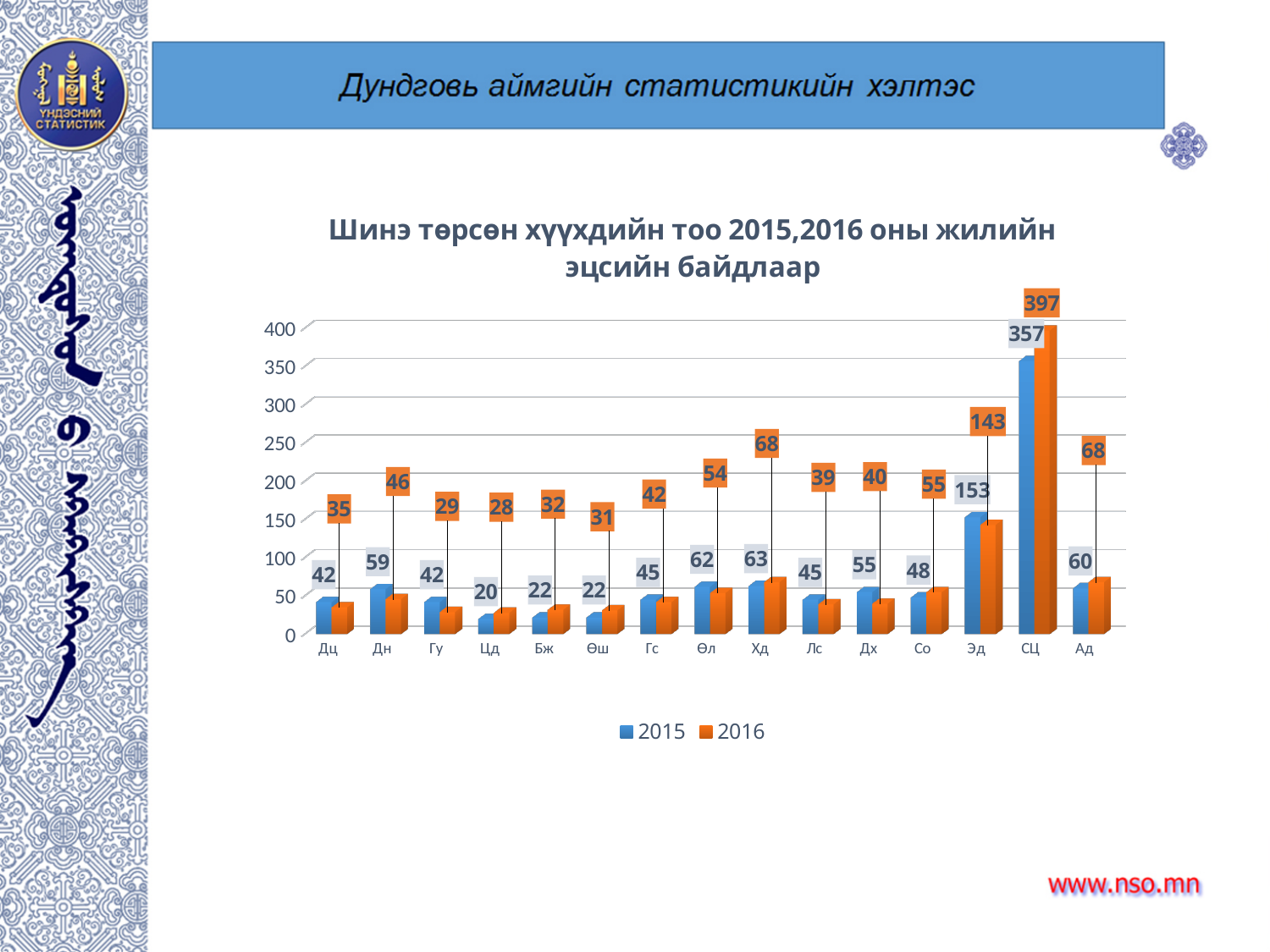
Which colour represents the 2016 series in the legend? orange What is the 2016 value for Цд? 28 What is the 2015 value for СЦ? 357 Which is larger for Дн, the 2015 value or the 2016 value? 2015 Which category has the lowest 2015 value? Цд What is the difference between the 2016 and 2015 values for СЦ? 40 Which category has the highest 2016 value? СЦ Is the 2015 value for Эд greater or less than 100? greater How many categories are shown on the x axis? 15 How many series does the legend list? 2 What is the 2016 value for Эд? 143 What type of chart is shown on the slide? bar chart